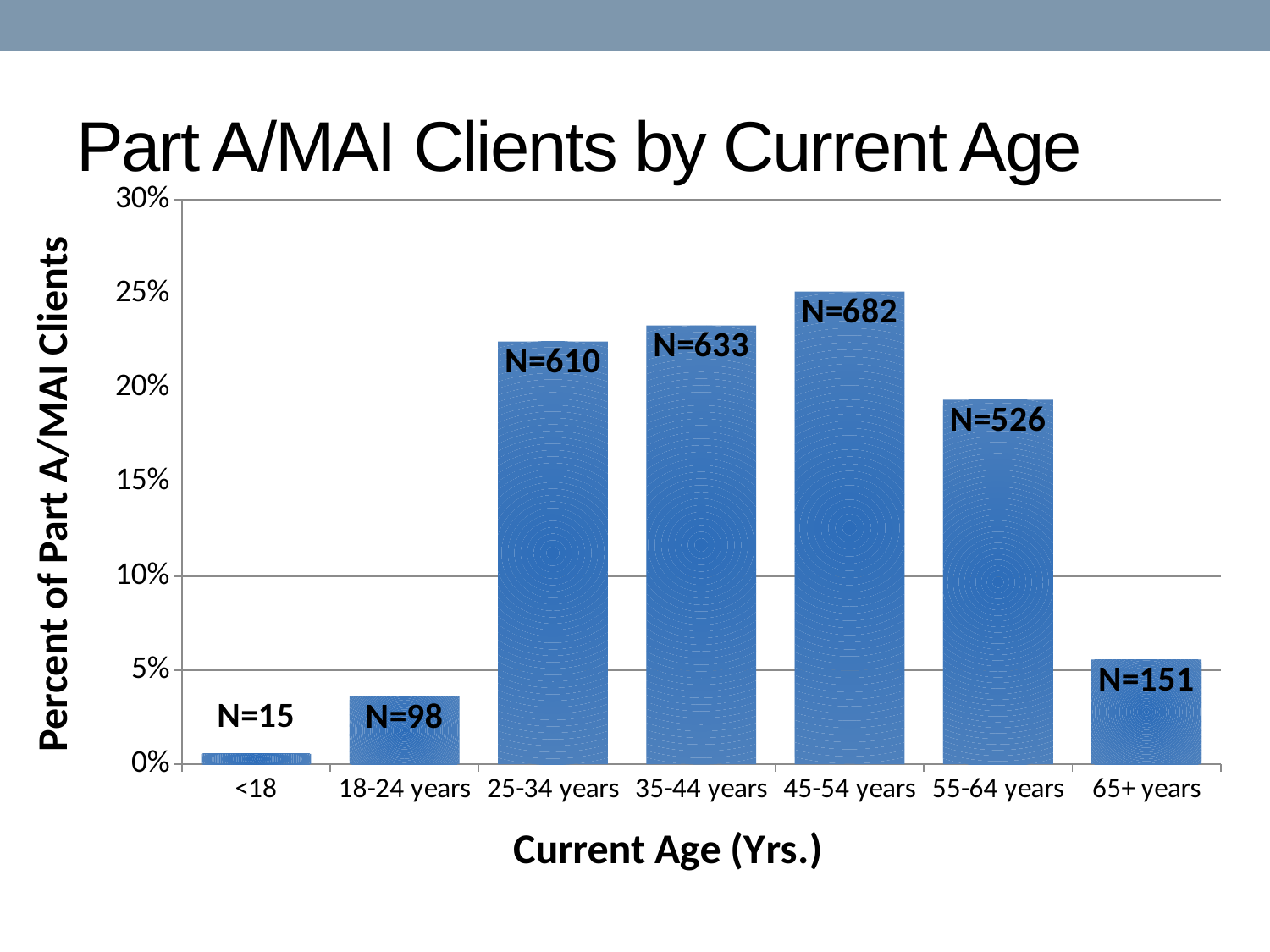
What is the difference between the N values for 45-54 years and 35-44 years? 49 Is the value for 55-64 years greater or less than 20%? less Which age category has the highest percent of Part A/MAI clients? 45-54 years How many age categories are shown on the x axis? 7 Which has a larger percent of Part A/MAI clients, 55-64 years or 65+ years? 55-64 years What is the title of the chart? Part A/MAI Clients by Current Age Which age category has the lowest percent of Part A/MAI clients? <18 What is the N value labelled on the bar for 45-54 years? N=682 What is the N value labelled on the bar for <18? N=15 What is the N value labelled on the bar for 65+ years? N=151 What type of chart is shown on the slide? bar chart